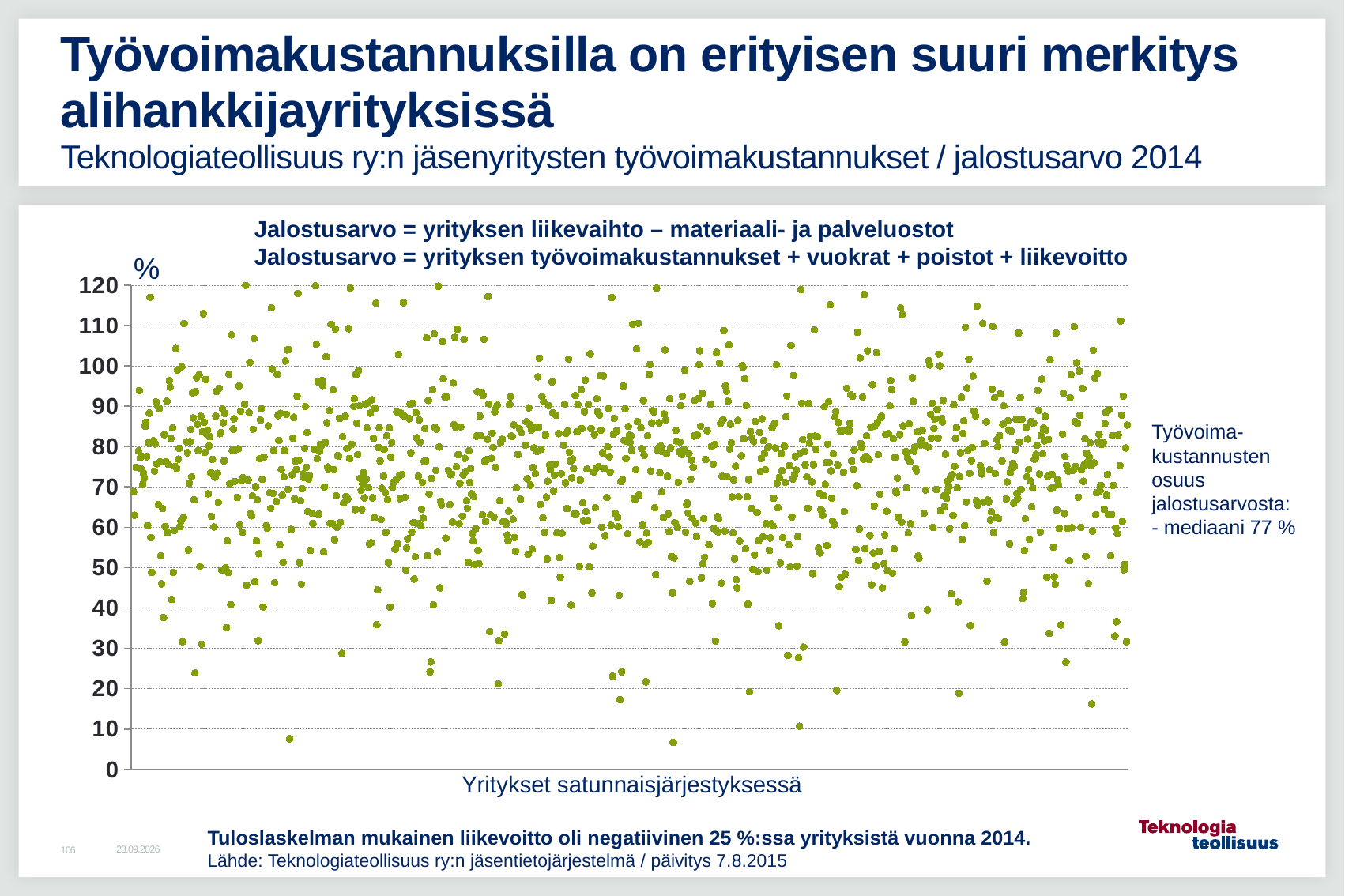
Is the median share of labour costs in value added (77 %) greater or less than 80? less What kind of chart is shown on the slide? scatter chart What is the label of the x axis of the chart? Yritykset satunnaisjärjestyksessä According to the note below the chart, in what share of companies was operating profit negative in 2014? 25 % What is the highest value shown on the y axis of the chart? 120 Is the median share of labour costs in value added (77 %) greater or less than 70? greater According to the slide, what is the median share of labour costs in value added (jalostusarvo)? 77 %